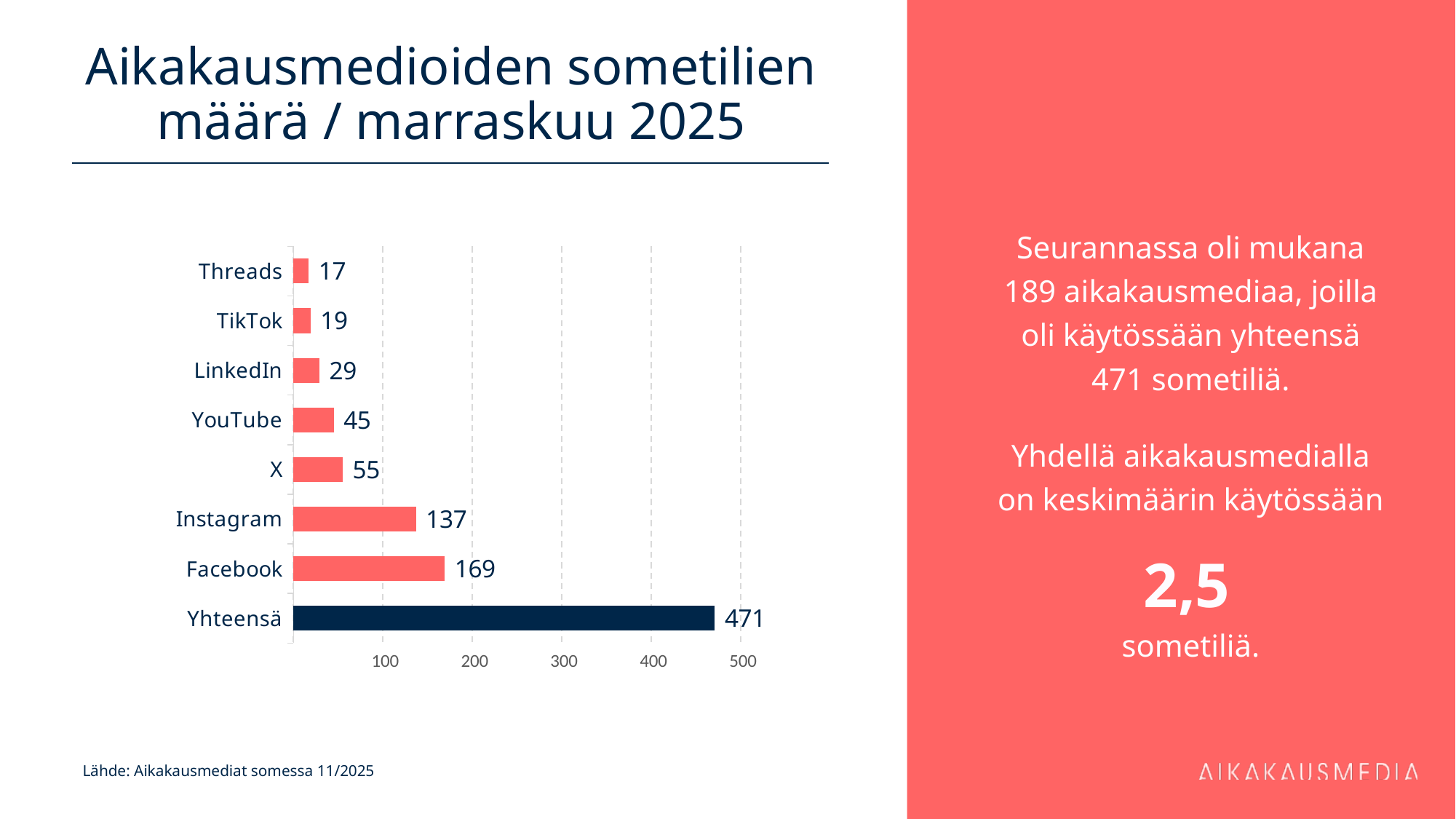
What is the title of the slide? Aikakausmedioiden sometilien määrä / marraskuu 2025 Which category has the lowest value? Threads What is the value for Yhteensä? 471 Which platform (excluding Yhteensä) has the highest value? Facebook What is the value for Instagram? 137 Is the value for Instagram greater or less than 100? greater What is the value for LinkedIn? 29 What is the value for Facebook? 169 What is the difference between the values for Facebook and Instagram? 32 Which is larger, the value for X or the value for YouTube? X What kind of chart is shown on the slide? bar chart How many categories are shown in the chart? 8